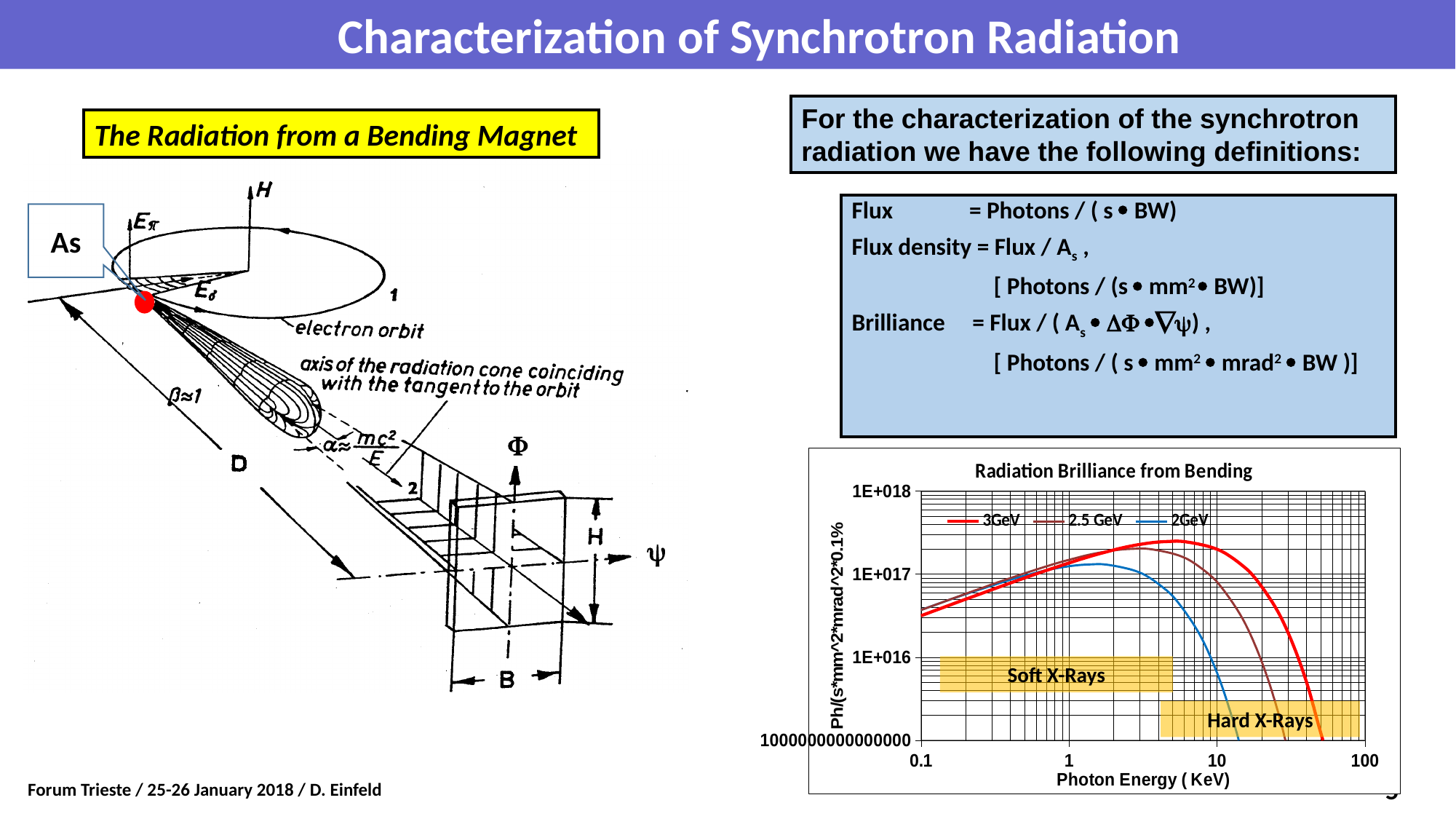
What is the x-axis label of the "Radiation Brilliance from Bending" chart? Photon Energy ( KeV) In the "Radiation Brilliance from Bending" chart, which series has the lowest brilliance at 10 KeV? 2GeV How many series does the legend of the "Radiation Brilliance from Bending" chart list? 3 In the "Radiation Brilliance from Bending" chart, which is larger at 10 KeV: the 3GeV curve or the 2GeV curve? 3GeV In the "Radiation Brilliance from Bending" chart, how does the 3GeV curve behave as photon energy increases from 0.1 to 100 KeV? rises to a peak, then falls In the "Radiation Brilliance from Bending" chart, which series falls off at the lowest photon energy? 2GeV In the "Radiation Brilliance from Bending" chart, is the peak value of the 3GeV curve greater or less than 1E+017? greater In the "Radiation Brilliance from Bending" chart, is the value of the 3GeV curve at 10 KeV greater or less than 1E+017? greater In the "Radiation Brilliance from Bending" chart, which series reaches the highest peak brilliance? 3GeV What kind of chart is "Radiation Brilliance from Bending"? line chart What are the three series shown in the legend of the "Radiation Brilliance from Bending" chart? 3GeV, 2.5 GeV, 2GeV